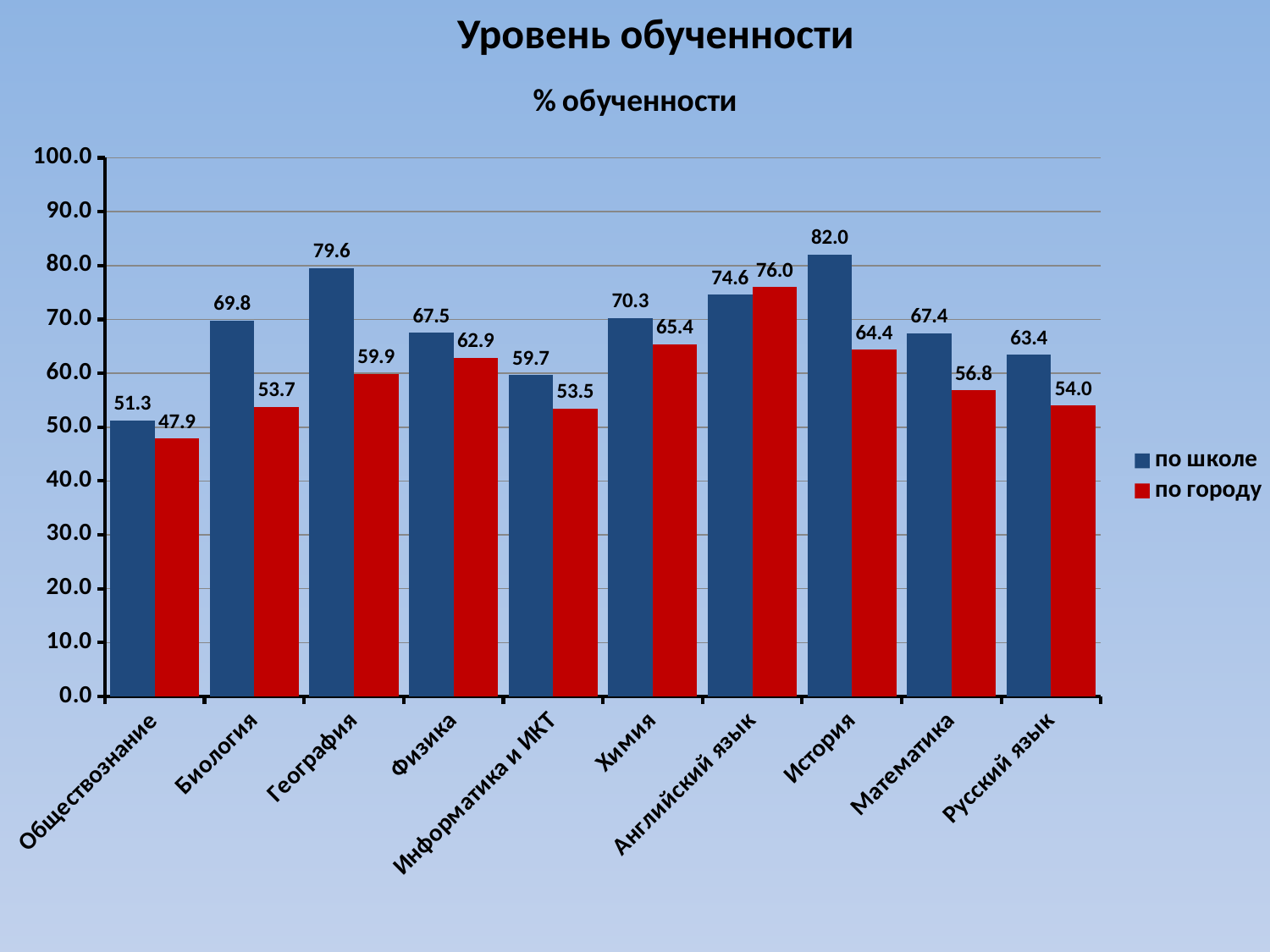
What is the difference between the "по школе" and "по городу" values for География? 19.7 What is the value for "по городу" for Физика? 62.9 Which category has the highest value for "по школе"? История Which category has the lowest value for "по городу"? Обществознание What is the title of the chart? % обученности For Английский язык, which is larger: the "по школе" value or the "по городу" value? по городу How many categories are shown on the x axis? 10 What is the value for "по городу" for Обществознание? 47.9 How many series does the legend list? 2 Is the "по школе" value for Биология greater or less than 60.0? greater What kind of chart is shown on the slide? bar chart What is the value for "по школе" for История? 82.0